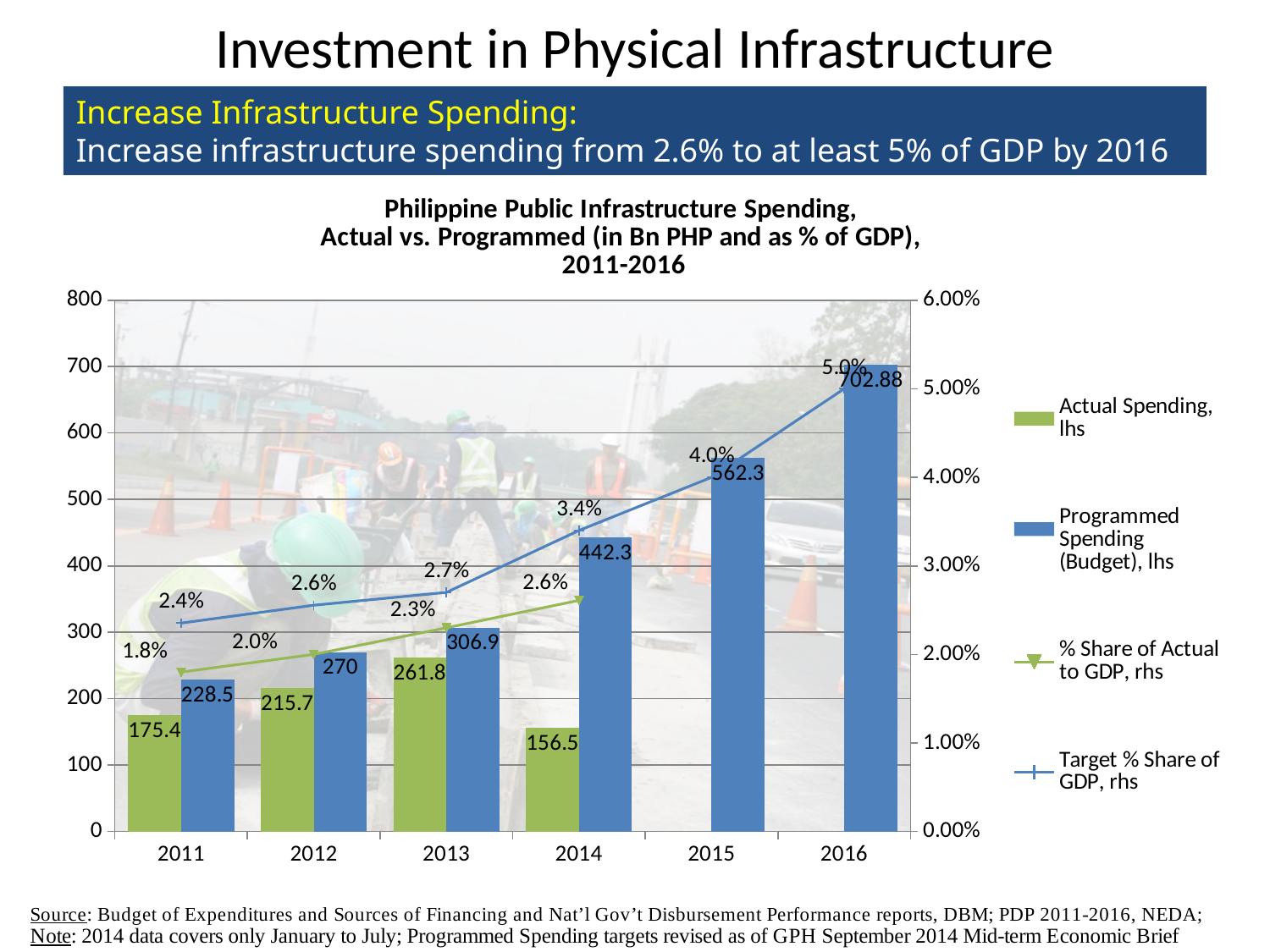
What kind of chart is this? Combination bar and line chart Does the Target % Share of GDP rise or fall from 2011 to 2016? rise Which year has the highest Programmed Spending (Budget)? 2016 What is the Target % Share of GDP for 2014? 3.4% What is the Actual Spending value for 2013? 261.8 Is the Programmed Spending (Budget) value for 2015 greater or less than 500? greater In 2012, which is larger: Actual Spending or Programmed Spending (Budget)? Programmed Spending (Budget) How many series does the legend list? 4 What is the difference between Programmed Spending and Actual Spending in 2014? 285.8 Which year has the lowest Actual Spending? 2014 How many years are shown on the x axis? 6 What is the Programmed Spending (Budget) value for 2016? 702.88